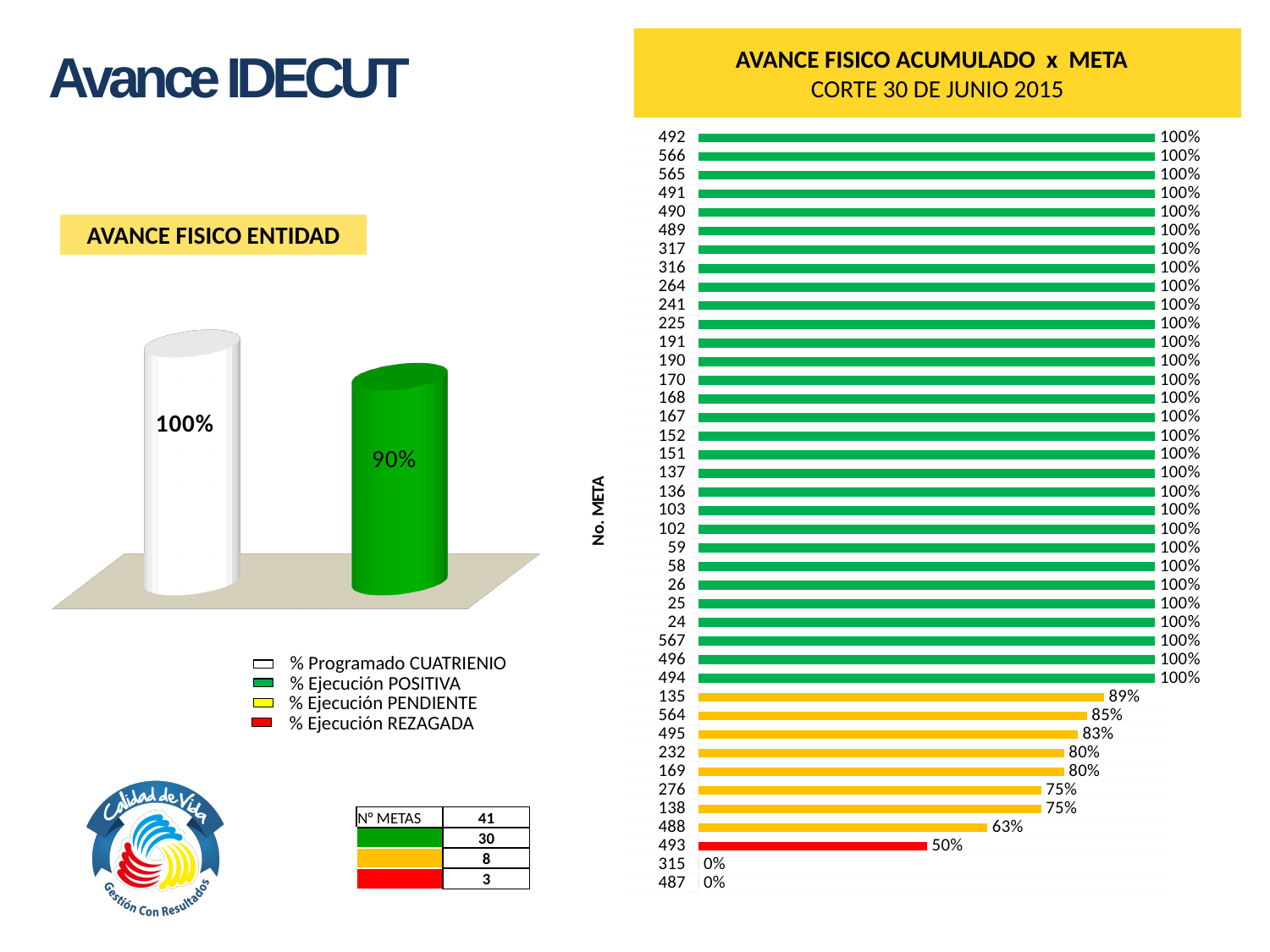
In the AVANCE FISICO ACUMULADO x META chart, what is the value for meta 493? 50% In the AVANCE FISICO ACUMULADO x META chart, what is the value for meta 135? 89% In the AVANCE FISICO ENTIDAD chart, what is the value for % Ejecución POSITIVA? 90% In the AVANCE FISICO ACUMULADO x META chart, which meta is larger, 564 or 495? 564 What kind of chart is the AVANCE FISICO ENTIDAD chart? bar chart In the AVANCE FISICO ACUMULADO x META chart, what is the difference between the values for meta 135 and meta 488? 26% In the AVANCE FISICO ENTIDAD chart, what is the difference between % Programado CUATRIENIO and % Ejecución POSITIVA? 10% How many entries does the legend of the AVANCE FISICO ENTIDAD chart list? 4 In the AVANCE FISICO ACUMULADO x META chart, how many metas show a value of 100%? 30 In the AVANCE FISICO ACUMULADO x META chart, what is the value for meta 488? 63% How many metas are plotted in the AVANCE FISICO ACUMULADO x META chart? 41 In the AVANCE FISICO ENTIDAD chart, what is the value for % Programado CUATRIENIO? 100%